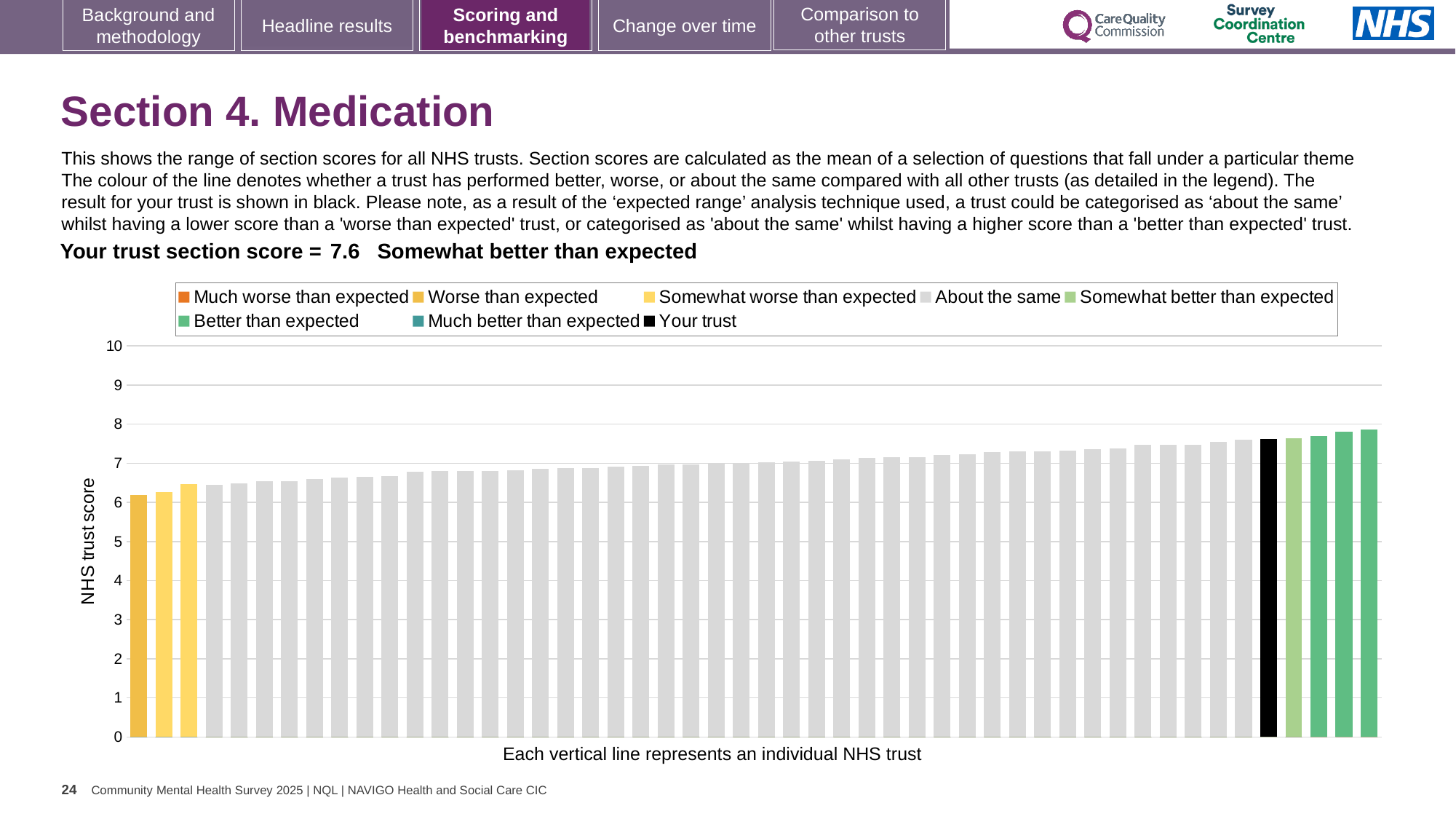
What colour is the bar representing your trust? black How many entries does the chart legend list? 8 Which is larger: the black 'Your trust' bar or the leftmost bar? Your trust Is the value of the tallest bar in the chart greater or less than 8? less Is the value of the black 'Your trust' bar greater or less than 7? greater What is the section score for your trust shown on the slide? 7.6 Which category is your trust placed in for this section? Somewhat better than expected What kind of chart is shown on the slide? bar chart Do the bar values rise or fall from left to right across the chart? rise Is the value of the leftmost (lowest) bar greater or less than 6? greater What is the label on the vertical axis of the chart? NHS trust score How many bars are shown to the right of the black 'Your trust' bar? 4